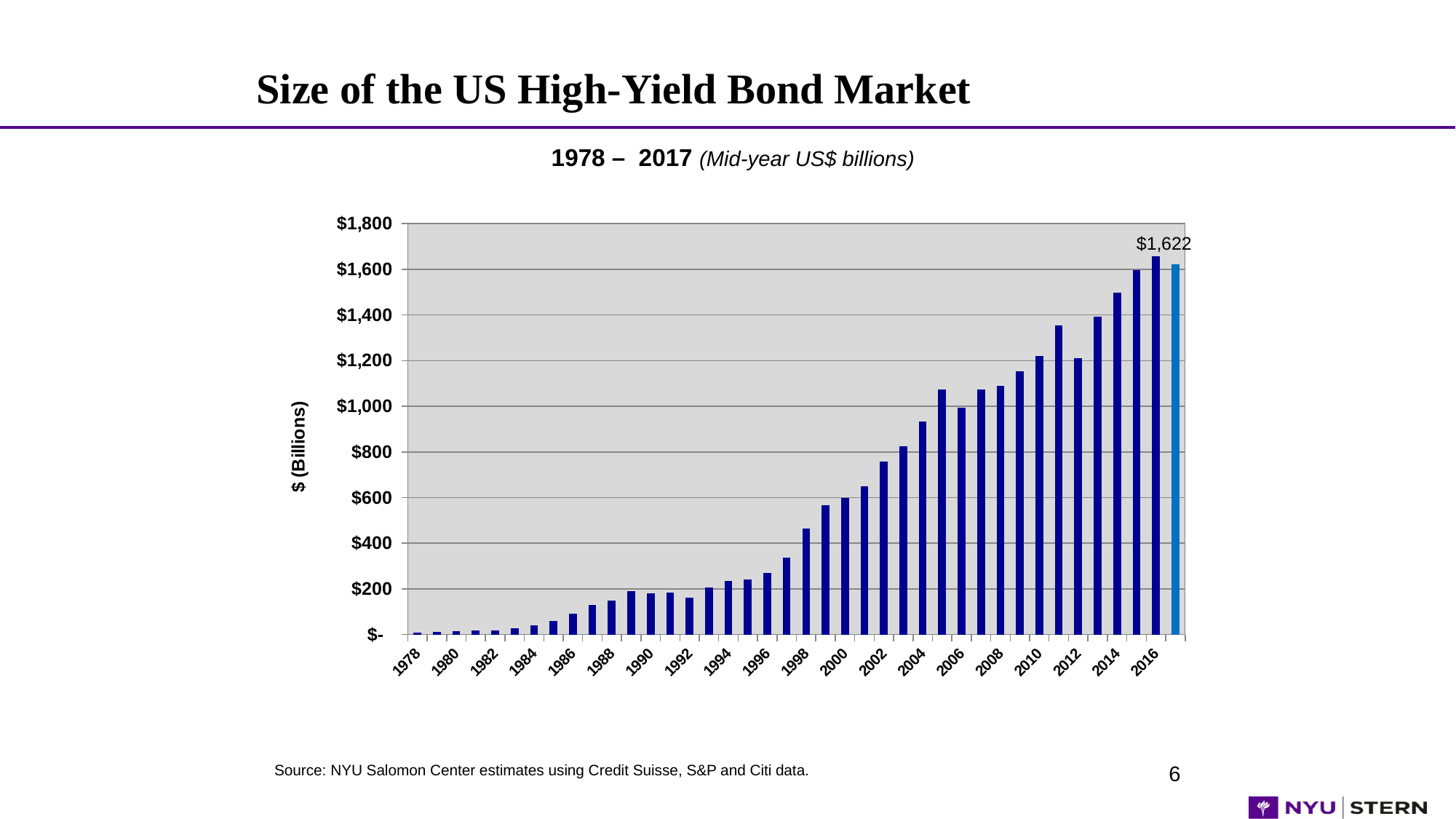
How many years (bars) are plotted on the chart? 40 Do the values generally rise or fall from 1978 to 2017? rise What is the label on the vertical axis of the chart? $ (Billions) Is the value for 2004 greater or less than $1,000? less Which year has the larger value, 2011 or 2012? 2011 What kind of chart is shown on the slide? bar chart Is the value for 1990 greater or less than $200? less What is the value of the US high-yield bond market in 2017? $1,622 Is the value for 2008 greater or less than $1,000? greater Which year has the larger value, 2006 or 2008? 2008 Which year has the lowest value on the chart? 1978